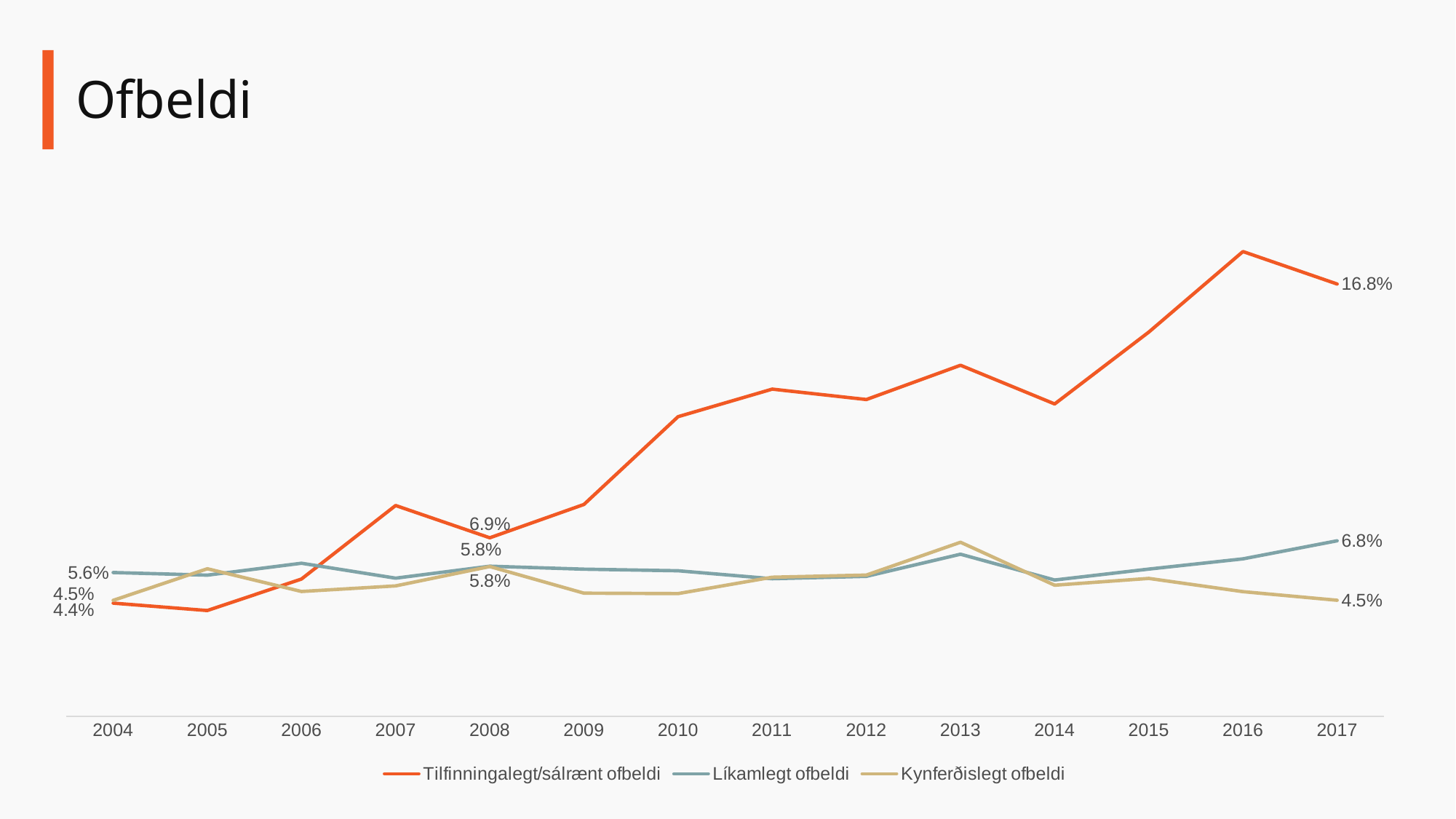
What kind of chart is shown on the slide? line chart What is the value for Tilfinningalegt/sálrænt ofbeldi in 2017? 16.8% What is the value for Líkamlegt ofbeldi in 2004? 5.6% What is the difference between Tilfinningalegt/sálrænt ofbeldi and Líkamlegt ofbeldi in 2017? 10.0% Which is larger in 2004, Líkamlegt ofbeldi or Tilfinningalegt/sálrænt ofbeldi? Líkamlegt ofbeldi What is the value for Tilfinningalegt/sálrænt ofbeldi in 2008? 6.9% What is the value for Kynferðislegt ofbeldi in 2017? 4.5% What is the value for Líkamlegt ofbeldi in 2017? 6.8% How many series does the legend list? 3 How many years are shown on the x axis? 14 Does the Tilfinningalegt/sálrænt ofbeldi line generally rise or fall from 2004 to 2017? rise Which series has the highest value in 2017? Tilfinningalegt/sálrænt ofbeldi